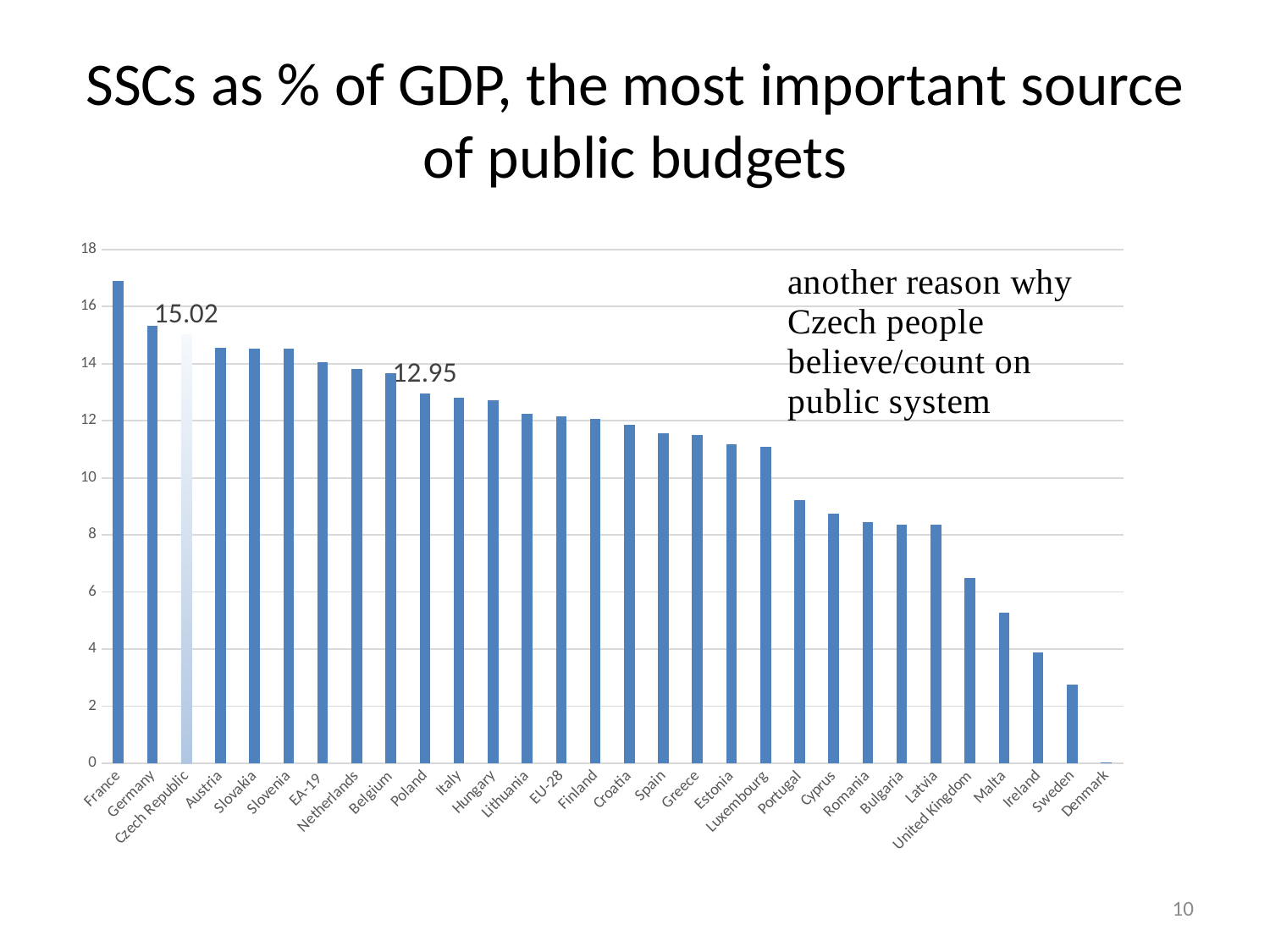
Is the value for France greater or less than 16? greater Which has a larger value, Germany or Malta? Germany What is the value shown for the Czech Republic? 15.02 Which country has the highest SSCs as % of GDP? France Is the value for Sweden greater or less than 4? less Which country has the lowest SSCs as % of GDP? Denmark What is the value shown for Poland? 12.95 Is the value for Portugal greater or less than 10? less Do the values rise or fall from left to right along the x axis? fall What kind of chart is shown on the slide? bar chart How many countries or regions are shown on the x axis? 30 What is the difference between the values for the Czech Republic and Poland? 2.07